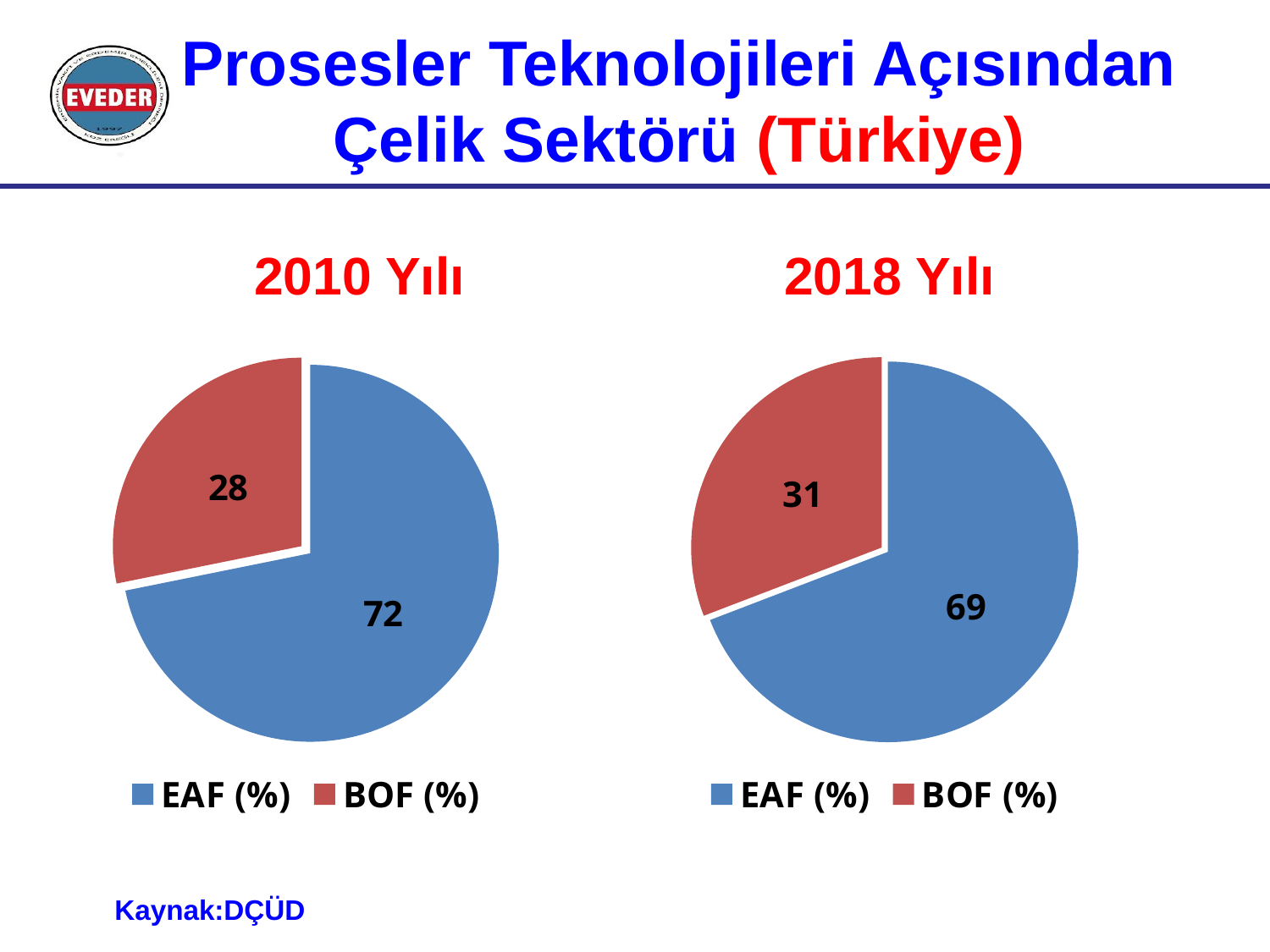
In the 2010 Yılı chart, which category has the largest slice? EAF (%) In the 2018 Yılı chart, what is the difference between the EAF (%) and BOF (%) values? 38 In the 2018 Yılı chart, what is the value for EAF (%)? 69 In the 2010 Yılı chart, what is the difference between the EAF (%) and BOF (%) values? 44 What kind of chart is the 2010 Yılı chart? Pie chart Is the BOF (%) value larger in the 2010 Yılı chart or the 2018 Yılı chart? 2018 Yılı How many slices does the 2018 Yılı chart have? 2 In the 2018 Yılı chart, which category has the smallest slice? BOF (%) In the 2018 Yılı chart, what colour is the EAF (%) slice? Blue In the 2018 Yılı chart, what is the value for BOF (%)? 31 In the 2010 Yılı chart, what is the value for EAF (%)? 72 In the 2010 Yılı chart, what is the value for BOF (%)? 28